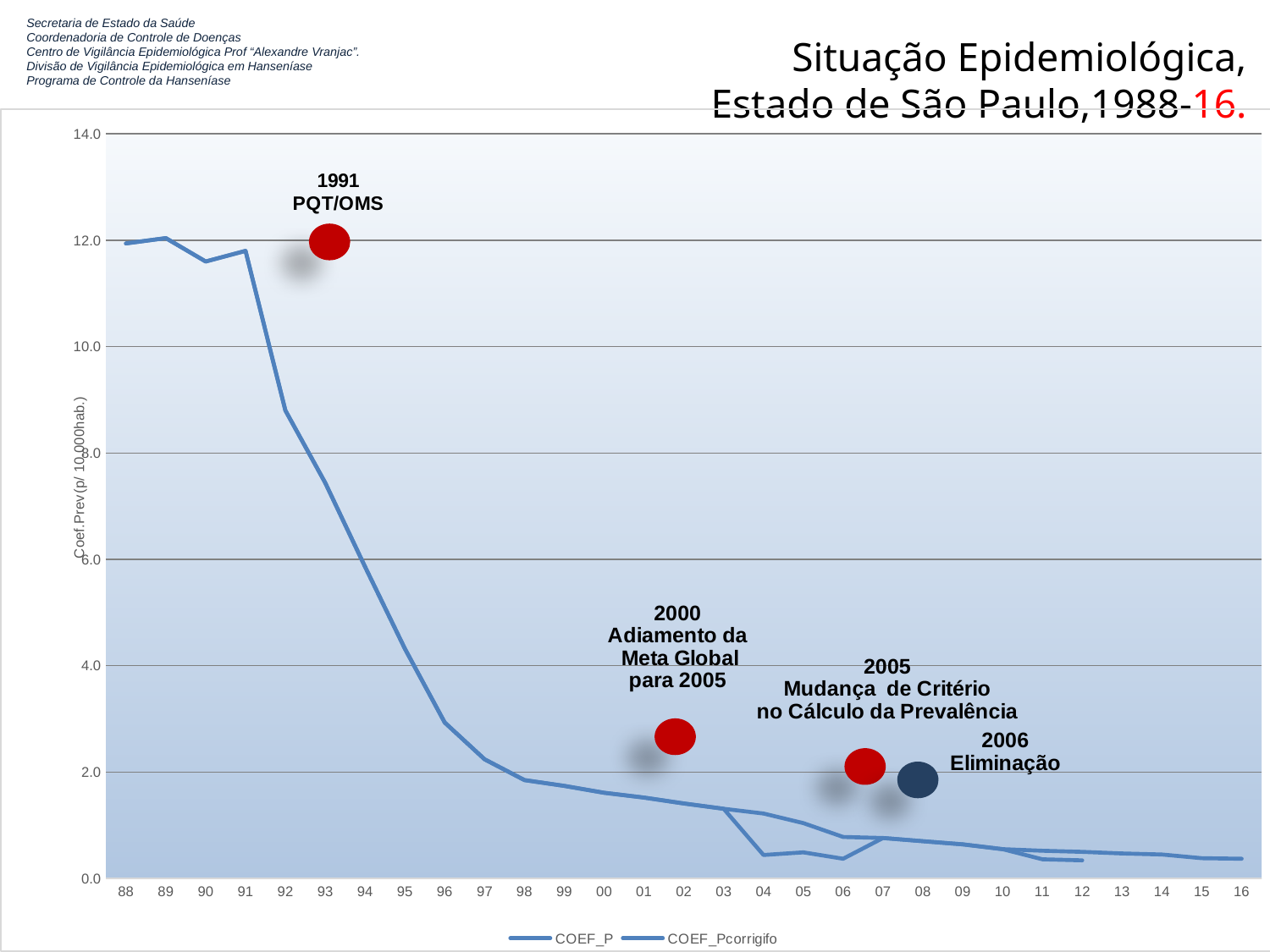
Which year has the larger value, 88 or 96? 88 What is the label on the y axis? Coef.Prev(p/ 10.000hab.) Overall, do the values rise or fall from 88 to 16? fall How many years are shown on the x axis? 29 Is the value for 94 greater or less than 4.0? greater Is the value for 96 greater or less than 4.0? less Is the value for 16 greater or less than 2.0? less How many series does the legend list? 2 What kind of chart is shown on the slide? line chart What are the names of the two series in the legend? COEF_P and COEF_Pcorrigifo